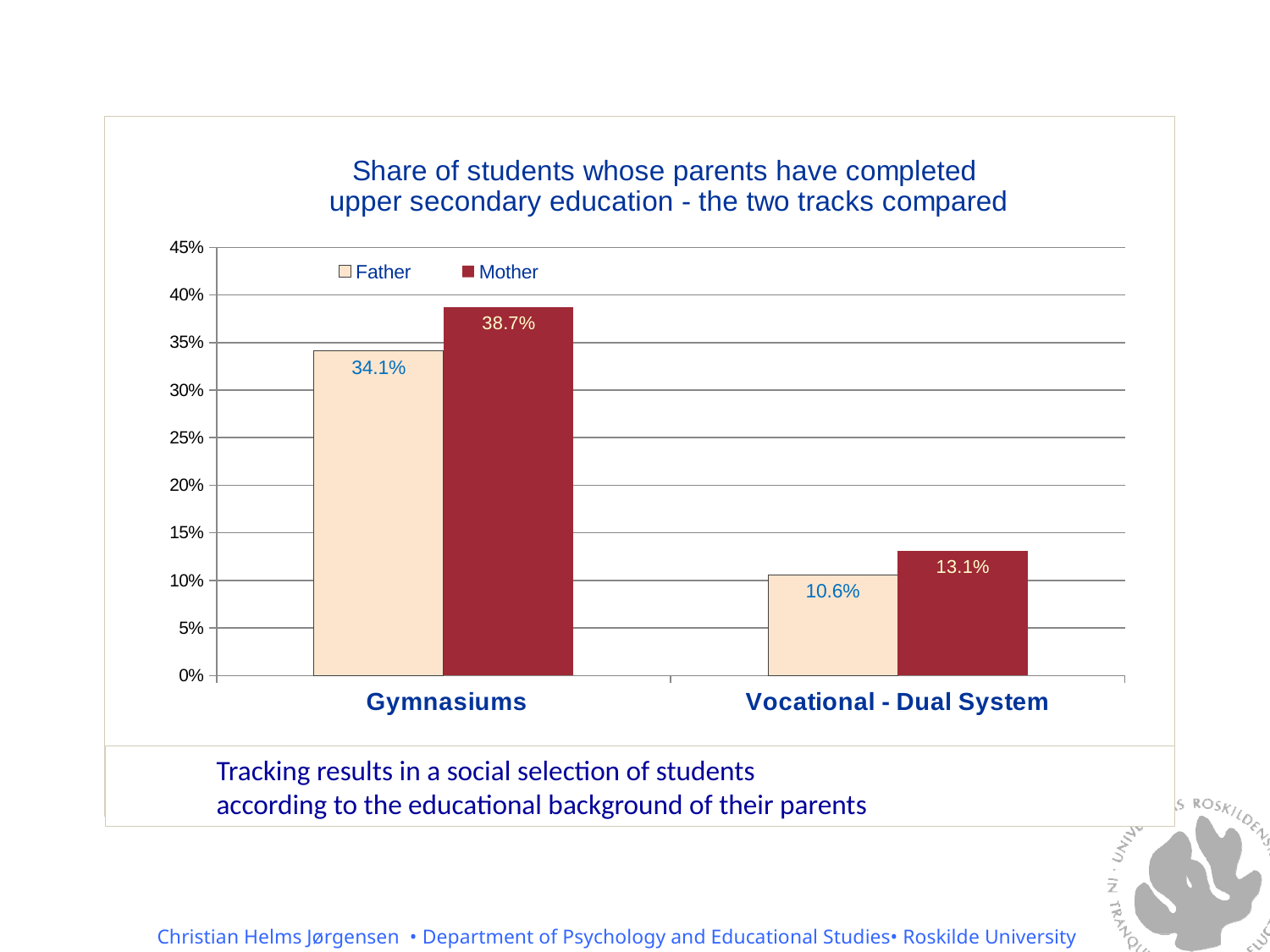
Which category has the highest value for Mother? Gymnasiums How many series does the legend list? 2 What is the value for Father in the Gymnasiums category? 34.1% Which category has the lowest value for Father? Vocational - Dual System What is the difference between the Mother and Father values in the Gymnasiums category? 4.6% How many categories are shown on the x axis? 2 What is the value for Mother in the Gymnasiums category? 38.7% What is the difference between the Father values for Gymnasiums and Vocational - Dual System? 23.5% What is the value for Mother in the Vocational - Dual System category? 13.1% What is the value for Father in the Vocational - Dual System category? 10.6% In the Vocational - Dual System category, which is larger, the Father value or the Mother value? Mother What kind of chart is shown on the slide? Bar chart